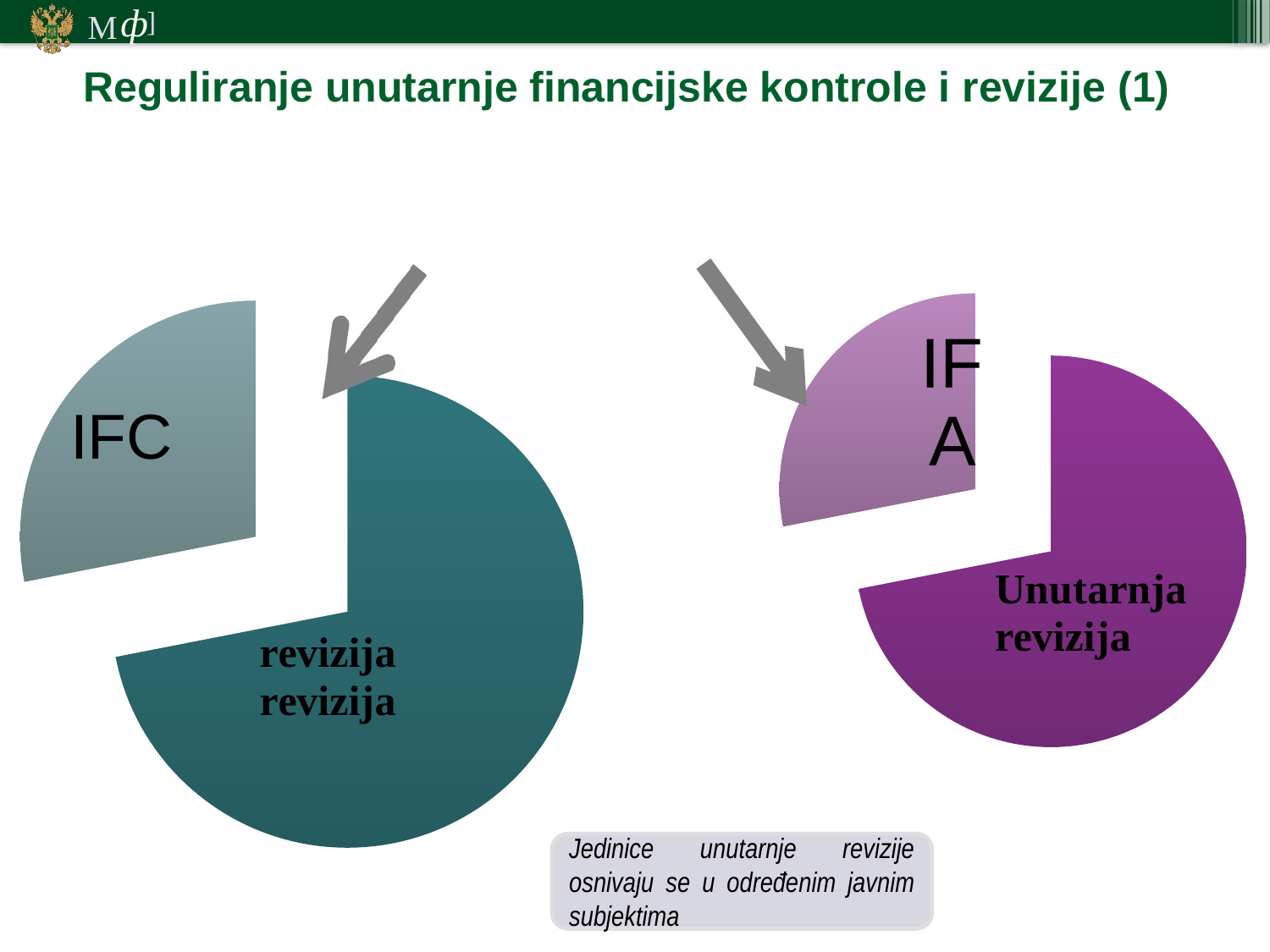
How many pie charts are shown on the slide? 2 How many slices does the right pie chart have? 2 What kind of chart is the left chart on the slide? pie chart What kind of chart is the right chart on the slide? pie chart How many slices does the left pie chart have? 2 In the right pie chart, which slice is larger: IFA or Unutarnja revizija? Unutarnja revizija In the left pie chart, which slice is the smallest? IFC In the left pie chart, which slice is larger: IFC or revizija revizija? revizija revizija What is the label of the pulled-out slice in the right pie chart? IFA What colour is the large slice of the right pie chart? purple In the right pie chart, which slice is the largest? Unutarnja revizija